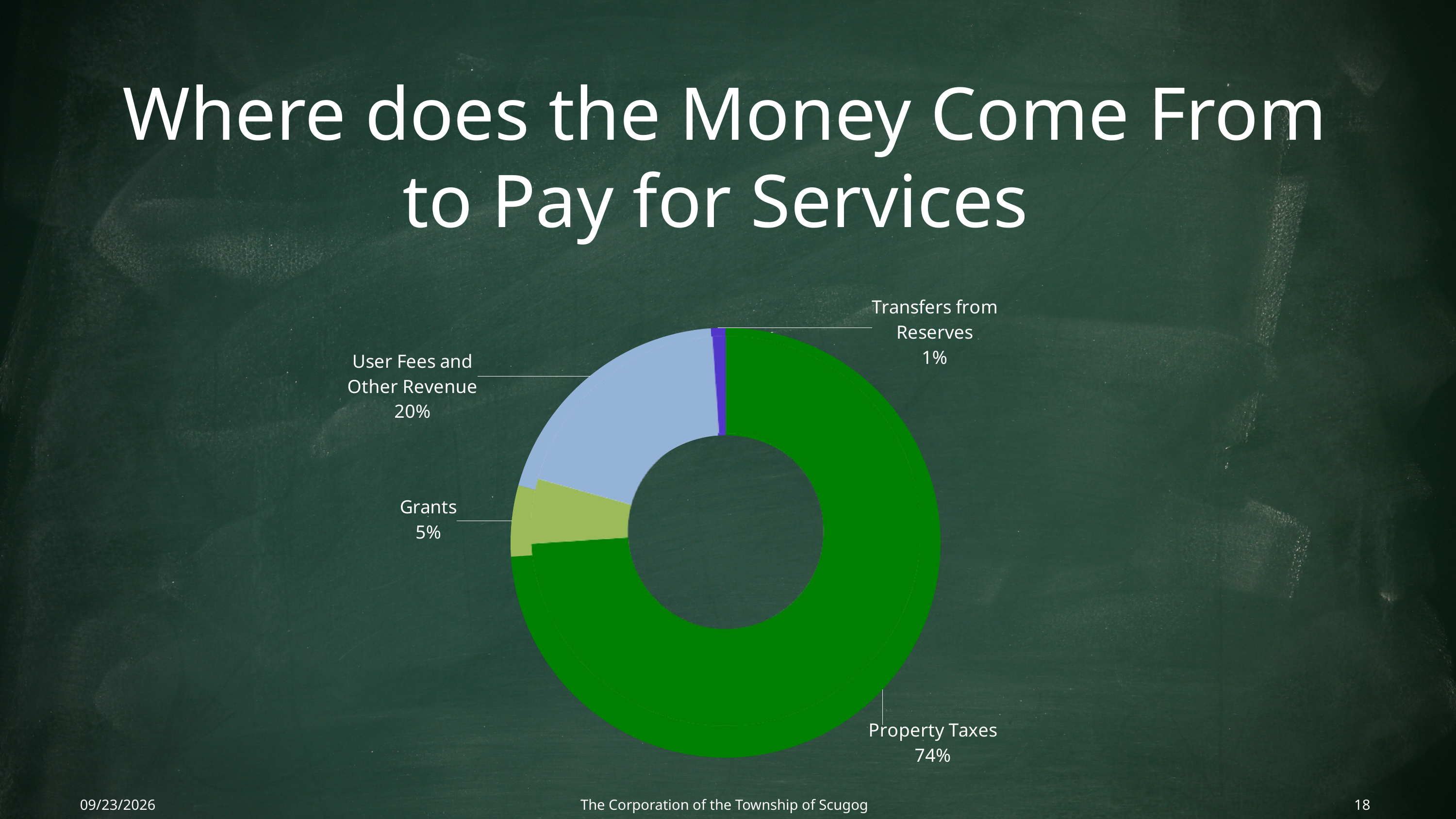
Which is larger, the share for Grants or the share for User Fees and Other Revenue? User Fees and Other Revenue What share of the money comes from Property Taxes? 74% What share of the money comes from Transfers from Reserves? 1% Which source provides the smallest share of the money? Transfers from Reserves How many revenue sources are shown in the chart? 4 What colour is the Property Taxes slice? Green What share of the money comes from User Fees and Other Revenue? 20% What kind of chart is shown on the slide? Doughnut (pie) chart How many percentage points larger is the Grants share than the Transfers from Reserves share? 4 What share of the money comes from Grants? 5% How many percentage points larger is the Property Taxes share than the User Fees and Other Revenue share? 54 Which source provides the largest share of the money? Property Taxes